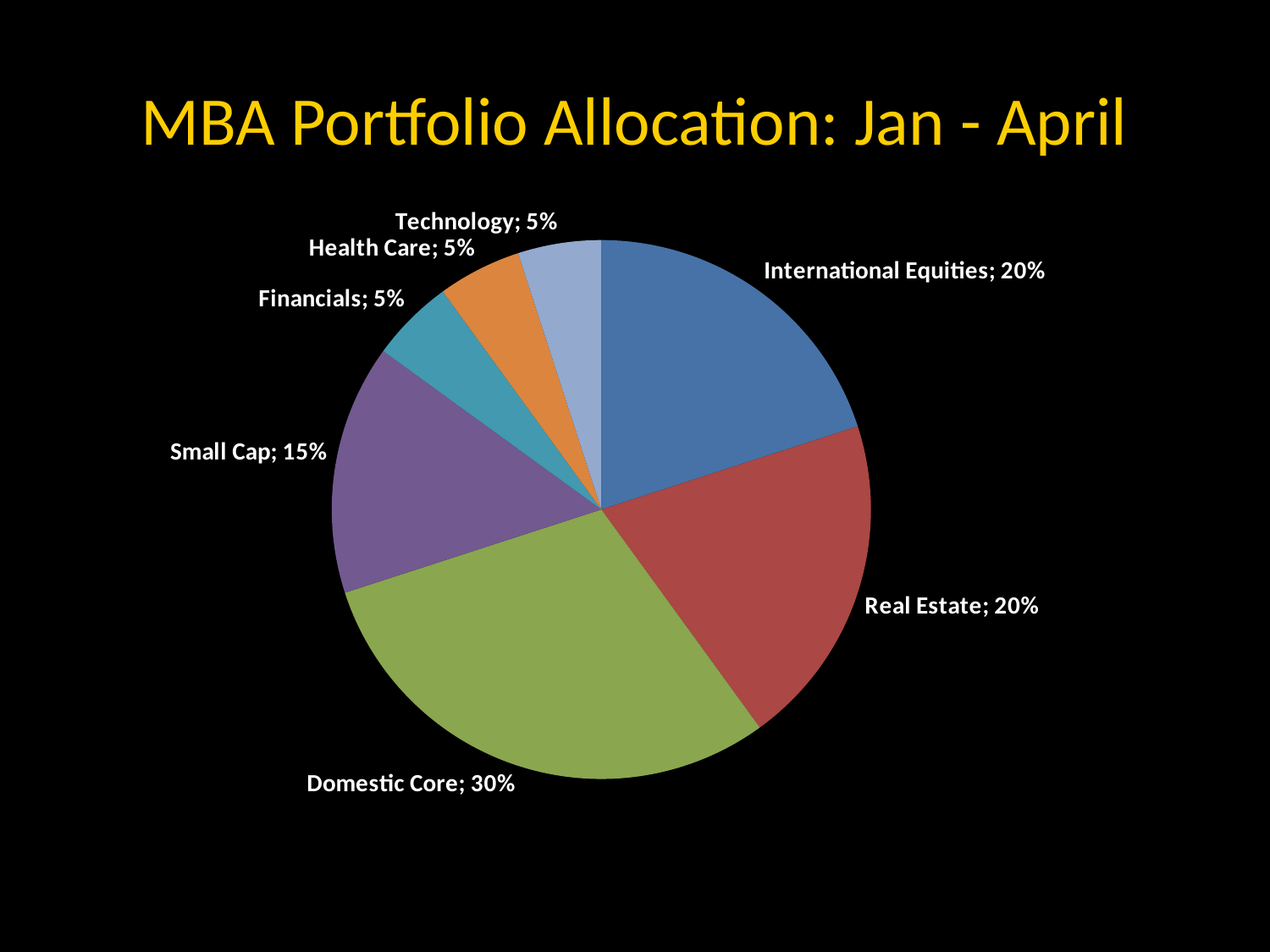
What is the title of the chart? MBA Portfolio Allocation: Jan - April What share of the portfolio is allocated to International Equities? 20% What kind of chart is shown on the slide? Pie chart What is the combined share of International Equities and Real Estate? 40% What share of the portfolio is allocated to Health Care? 5% What share of the portfolio is allocated to Small Cap? 15% Which is larger, the Real Estate share or the Small Cap share? Real Estate Which category is shown in the green slice? Domestic Core What share of the portfolio is allocated to Domestic Core? 30% What is the difference between the Domestic Core share and the Small Cap share? 15% How many slices does the pie chart have? 7 Which category has the largest share of the portfolio? Domestic Core